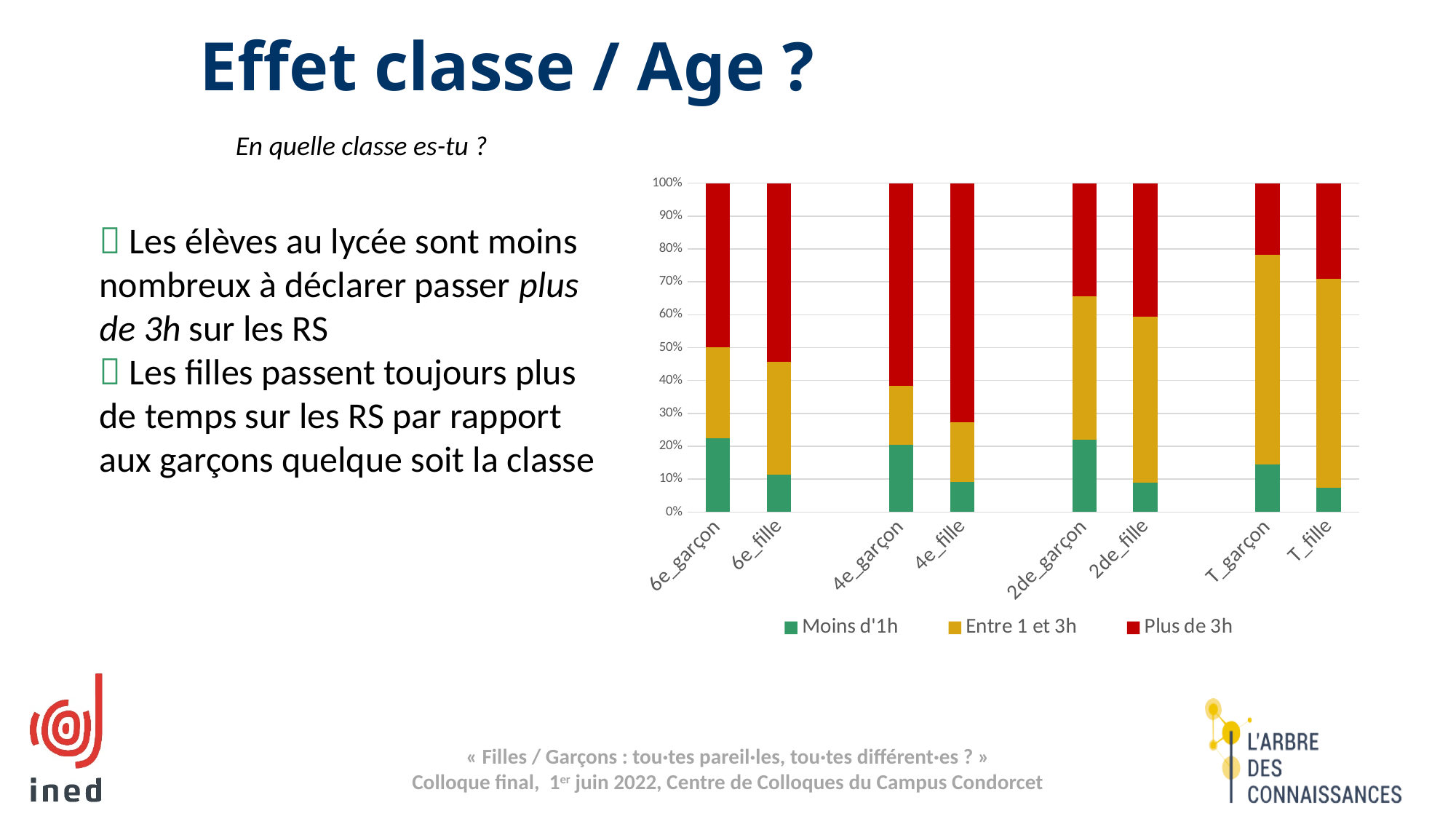
Which category has the smallest 'Plus de 3h' segment? T_garçon Which has a larger 'Moins d'1h' segment, 6e_garçon or 6e_fille? 6e_garçon What is the total height of the stacked bar for 6e_garçon? 100% Is the 'Moins d'1h' value for T_fille greater or less than 10%? less What are the three series listed in the chart legend? Moins d'1h, Entre 1 et 3h, Plus de 3h Which category has the largest 'Plus de 3h' segment? 4e_fille Which colour represents the 'Plus de 3h' series in the chart? Red Is the 'Moins d'1h' value for 6e_garçon greater or less than 10%? greater How many categories are shown on the x axis of the chart? 8 Is the 'Moins d'1h' value for 6e_fille greater or less than 20%? less What kind of chart is shown on the slide? Stacked bar chart How many series does the chart legend list? 3